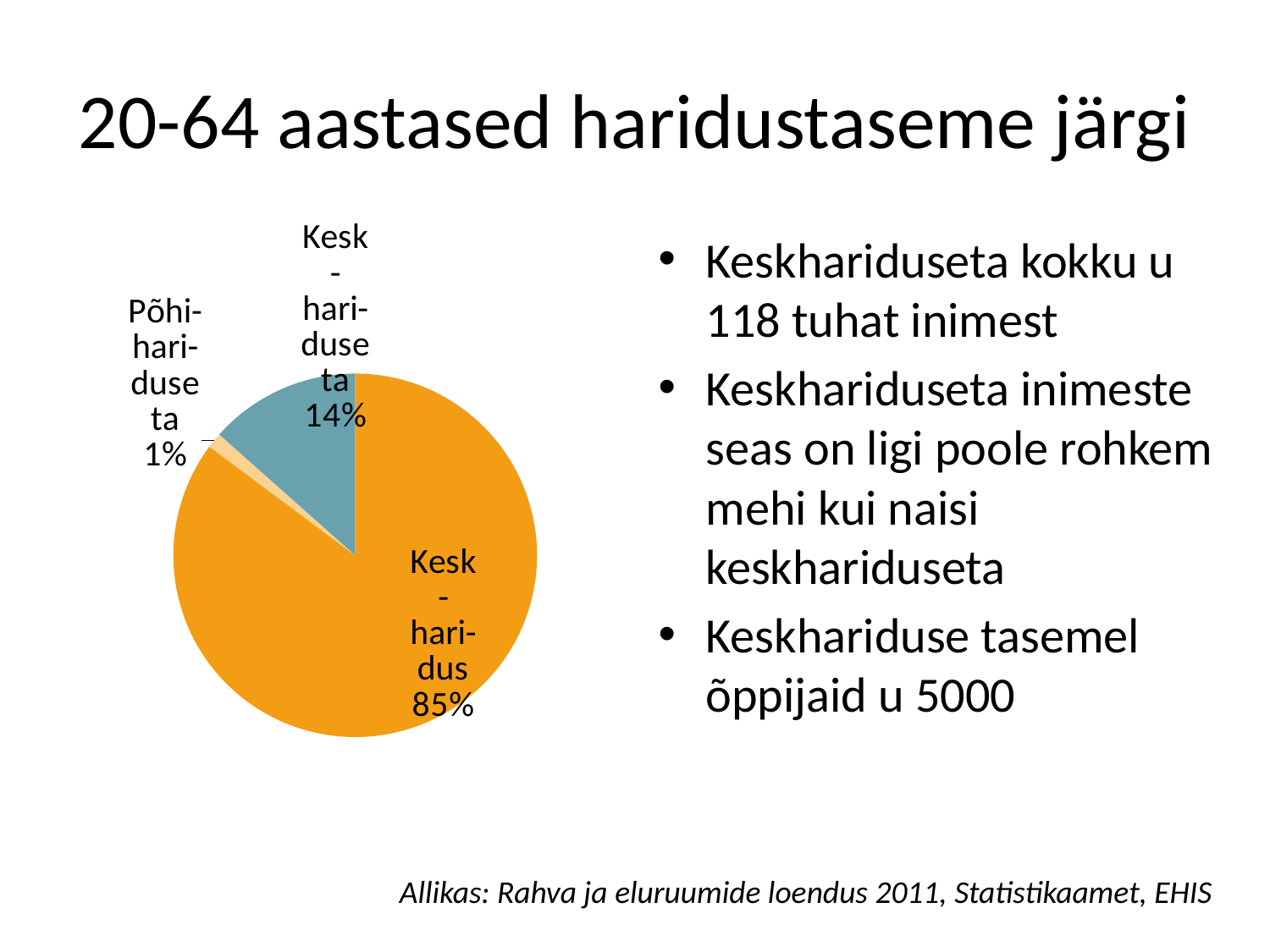
What is the difference in percentage points between the Keskharidus and Keskhariduseta slices? 71 What kind of chart is shown on the slide? pie chart Which slice of the pie chart is the smallest? Põhihariduseta How many slices does the pie chart have? 3 What share of the pie does the Põhihariduseta slice represent? 1% Which slice of the pie chart is the largest? Keskharidus What is the difference in percentage points between the Keskhariduseta and Põhihariduseta slices? 13 What is the title of the slide containing the pie chart? 20-64 aastased haridustaseme järgi What share of the pie does the Keskhariduseta slice represent? 14% What colour is the Keskharidus slice of the pie chart? orange What share of the pie does the Keskharidus slice represent? 85% Which slice is larger, Keskhariduseta or Põhihariduseta? Keskhariduseta